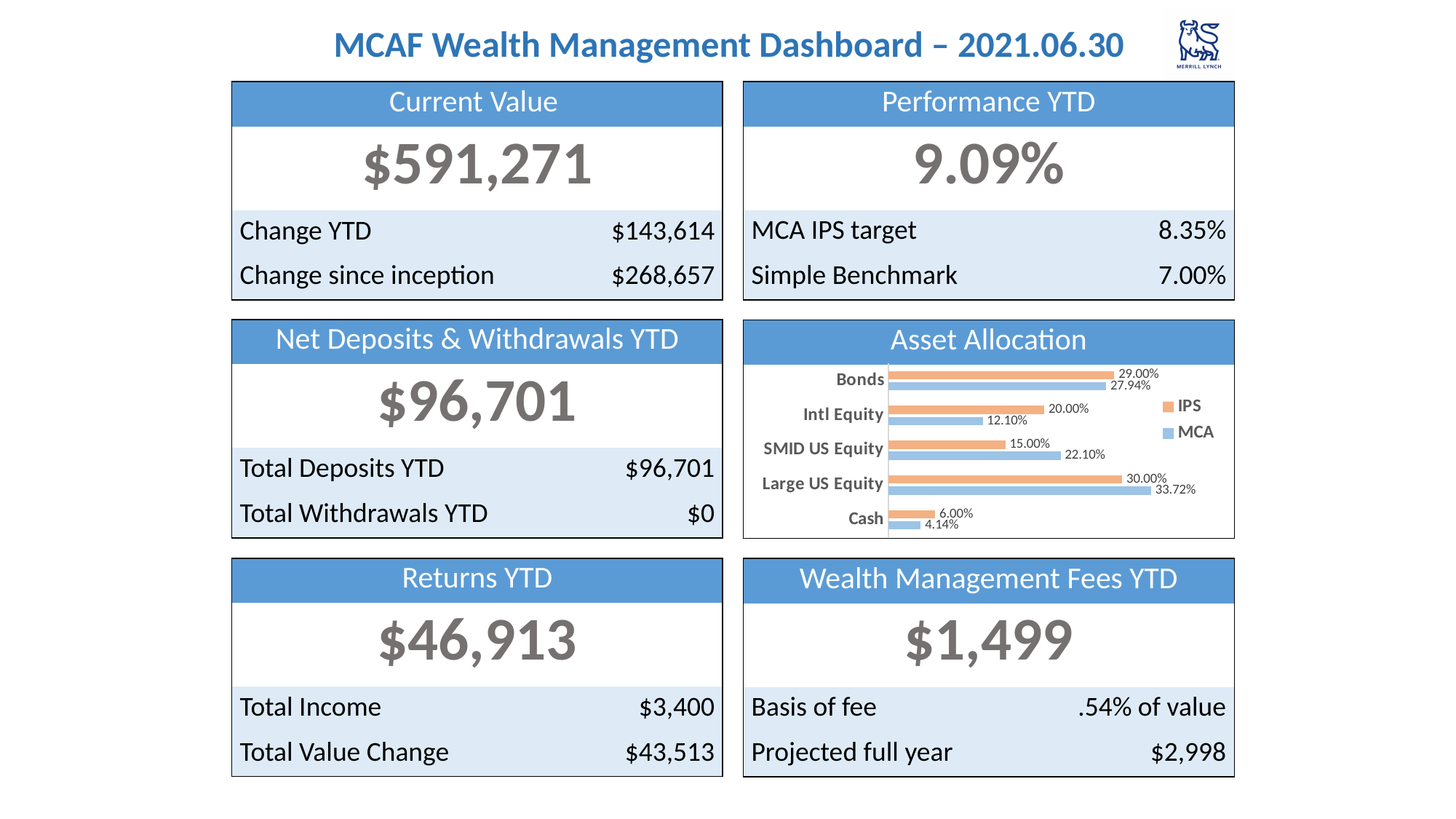
In the Asset Allocation chart, what is the MCA value for Intl Equity? 12.10% In the Asset Allocation chart, what is the MCA value for Large US Equity? 33.72% In the Asset Allocation chart, which is larger for Bonds, the IPS value or the MCA value? IPS In the Asset Allocation chart, what is the IPS value for Bonds? 29.00% In the Asset Allocation chart, what is the difference between the MCA and IPS values for SMID US Equity? 7.10% What kind of chart is the Asset Allocation chart? Bar chart How many categories are shown in the Asset Allocation chart? 5 How many series does the legend of the Asset Allocation chart list? 2 In the Asset Allocation chart, what is the difference between the IPS and MCA values for Intl Equity? 7.90% In the Asset Allocation chart, what is the IPS value for Cash? 6.00% In the Asset Allocation chart, which category has the highest MCA value? Large US Equity In the Asset Allocation chart, which category has the lowest IPS value? Cash